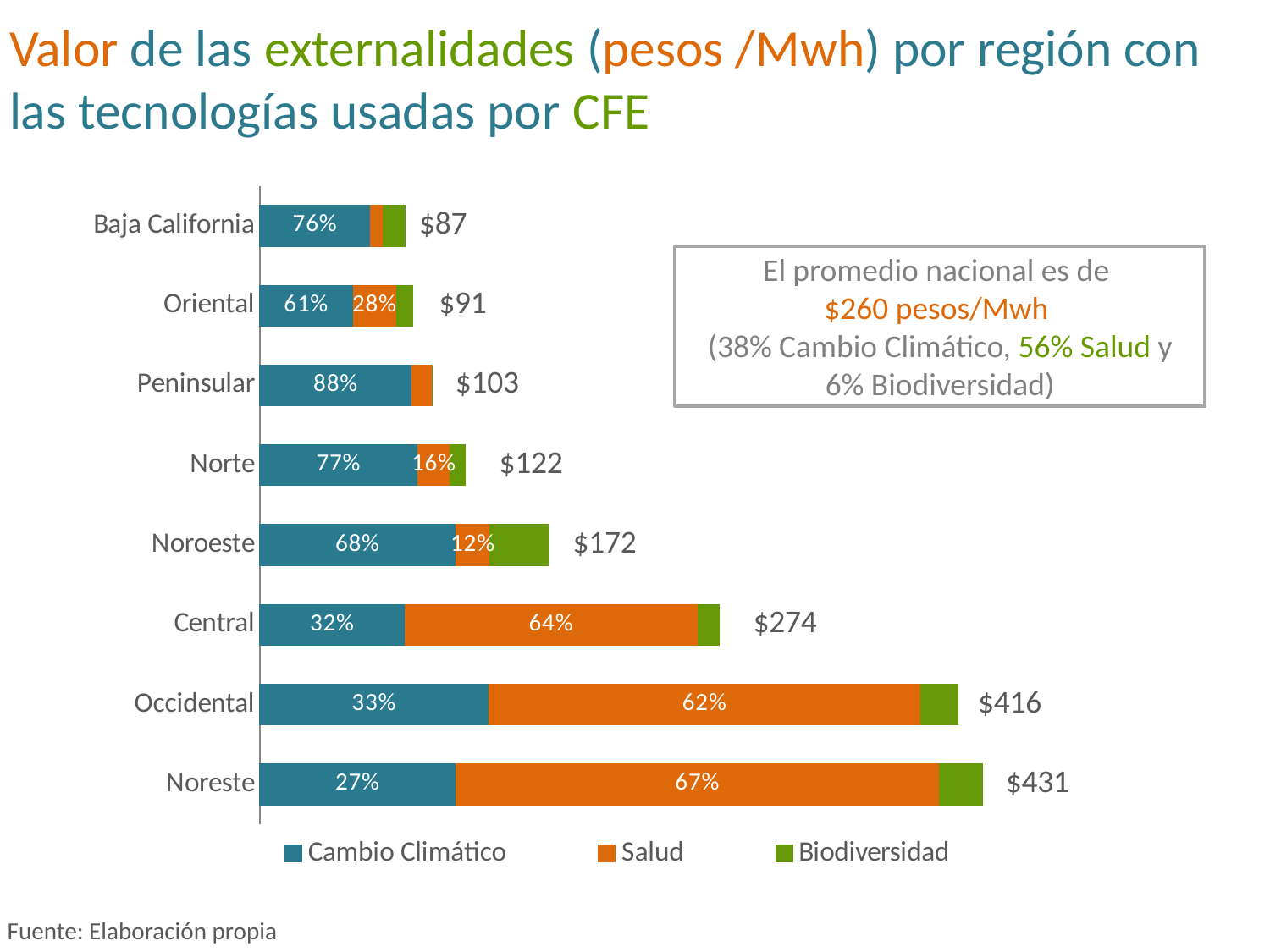
Which series is shown in green in the legend? Biodiversidad How many series does the legend list? 3 Which region has a larger total value of externalities, Noroeste or Norte? Noroeste What is the difference between the total for Occidental and the total for Central? $142 What kind of chart is shown on the slide? Stacked bar chart Which region has the lowest total value of externalities? Baja California Which region has the highest total value of externalities? Noreste What is the total value of externalities for Noreste? $431 What is the Salud percentage for Oriental? 28% How many regions are shown in the chart? 8 What share of Peninsular's externalities is Cambio Climático? 88% What percentage of Central's externalities comes from Salud? 64%